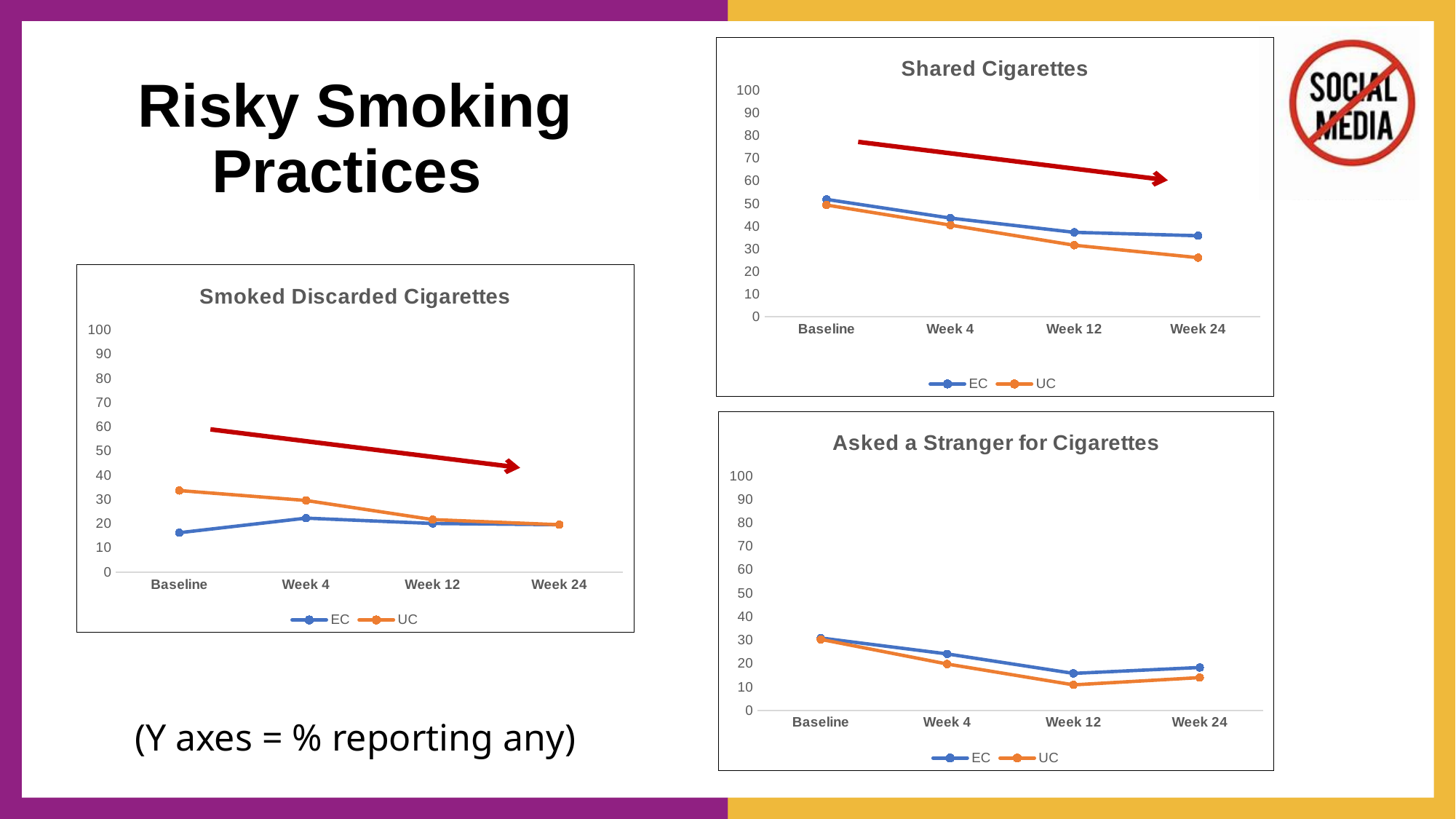
In the "Asked a Stranger for Cigarettes" chart, at which time point is the UC series lowest? Week 12 In the "Asked a Stranger for Cigarettes" chart, how many time points are shown on the x axis? 4 In the "Shared Cigarettes" chart, does the UC series rise or fall from Baseline to Week 24? Fall In the "Smoked Discarded Cigarettes" chart, is the EC value at Baseline greater or less than 20? less In the "Shared Cigarettes" chart, is the EC value at Baseline greater or less than 40? greater What are the two legend entries in the "Asked a Stranger for Cigarettes" chart? EC and UC In the "Smoked Discarded Cigarettes" chart, how many series does the legend list? 2 In the "Asked a Stranger for Cigarettes" chart, is the EC value at Week 12 greater or less than 20? less In the "Smoked Discarded Cigarettes" chart, at which time point is the UC series highest? Baseline In the "Smoked Discarded Cigarettes" chart, which series has the larger value at Baseline, EC or UC? UC What kind of chart is the "Shared Cigarettes" chart? Line chart